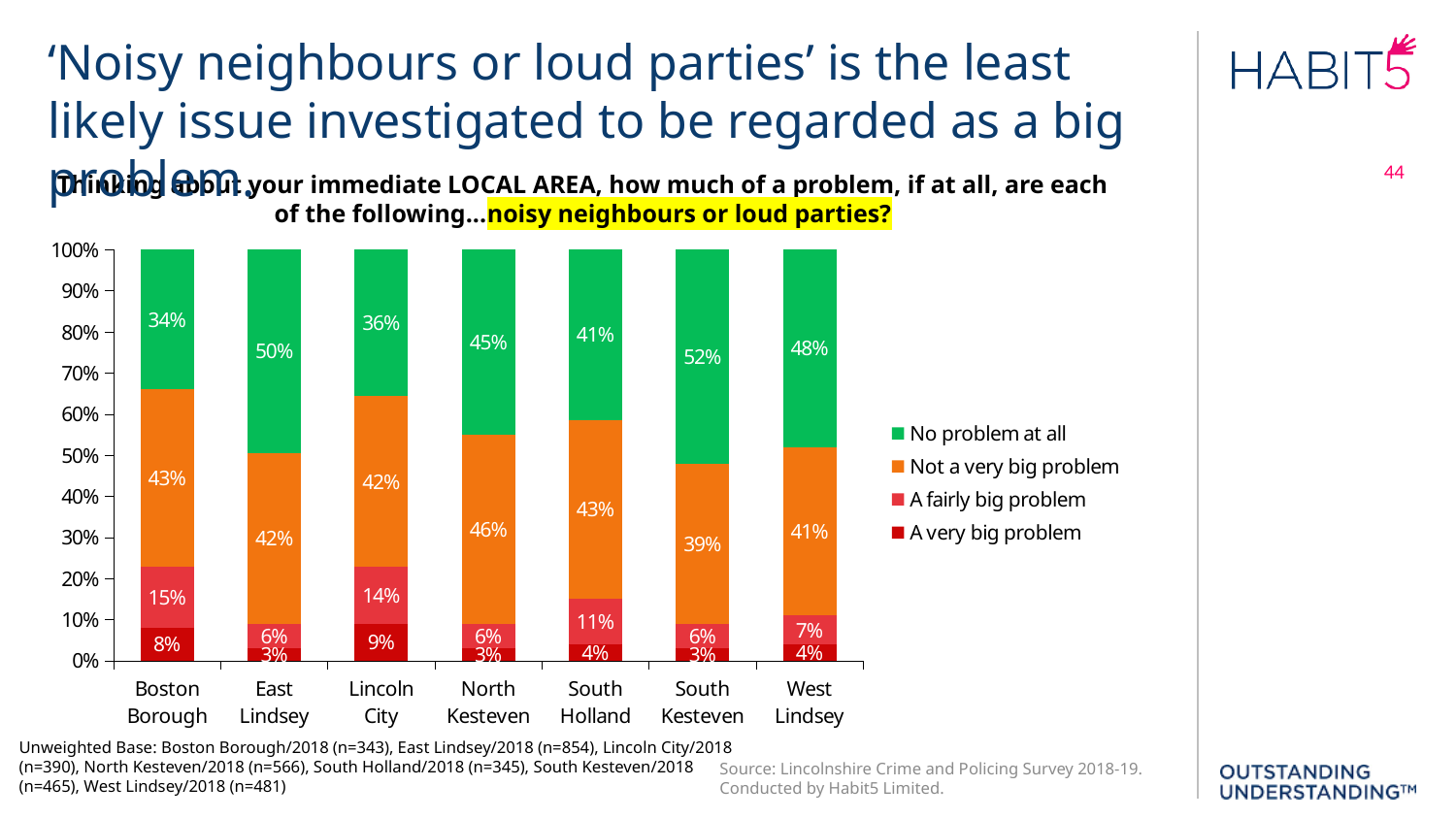
Which area has the lowest 'No problem at all' percentage? Boston Borough How many areas are shown on the x axis of the chart? 7 What is the 'A fairly big problem' value for South Holland? 11% Which colour represents 'No problem at all' in the chart legend? Green Which area has the highest 'No problem at all' percentage? South Kesteven What percentage of respondents in Boston Borough said noisy neighbours or loud parties are 'No problem at all'? 34% What is the difference between the 'No problem at all' values for South Kesteven and Boston Borough? 18 percentage points What is the 'Not a very big problem' value for North Kesteven? 46% What type of chart is shown on the slide? Stacked bar chart How many series does the chart legend list? 4 What is the 'A very big problem' value for Lincoln City? 9% Which area has the larger 'A fairly big problem' value, Boston Borough or West Lindsey? Boston Borough